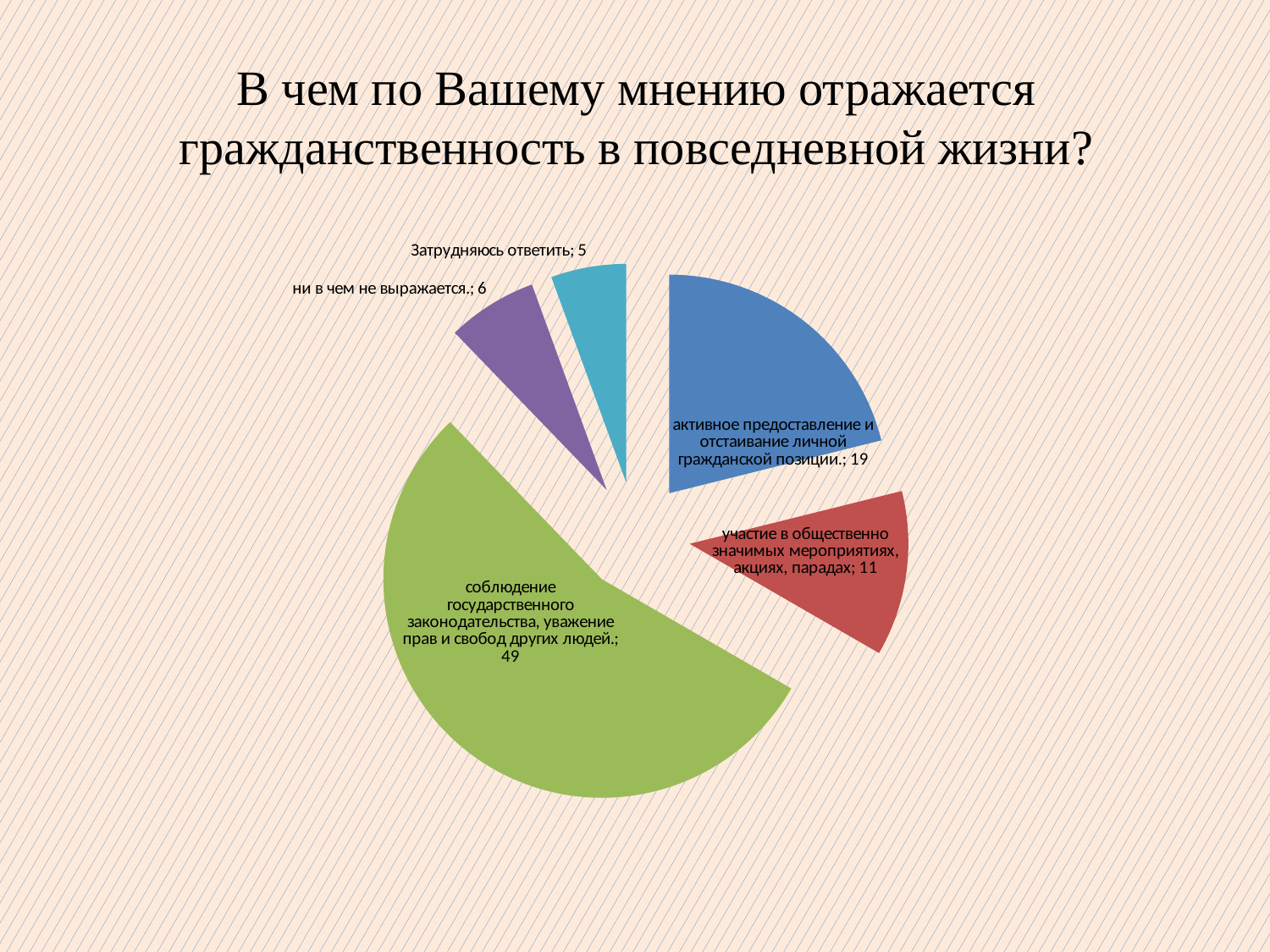
What kind of chart is shown on the slide? pie chart What is the difference between the values for "активное предоставление и отстаивание личной гражданской позиции." and "участие в общественно значимых мероприятиях, акциях, парадах"? 8 What is the value for "активное предоставление и отстаивание личной гражданской позиции."? 19 What is the value for "Затрудняюсь ответить"? 5 How many slices does the pie chart have? 5 Which is larger: the value for "ни в чем не выражается." or the value for "Затрудняюсь ответить"? ни в чем не выражается. What is the total of all the values shown in the pie chart? 90 Which category has the smallest slice? Затрудняюсь ответить What is the title of the slide above the chart? В чем по Вашему мнению отражается гражданственность в повседневной жизни? Which category has the largest slice? соблюдение государственного законодательства, уважение прав и свобод других людей. What is the value for "соблюдение государственного законодательства, уважение прав и свобод других людей."? 49 What is the value for "участие в общественно значимых мероприятиях, акциях, парадах"? 11